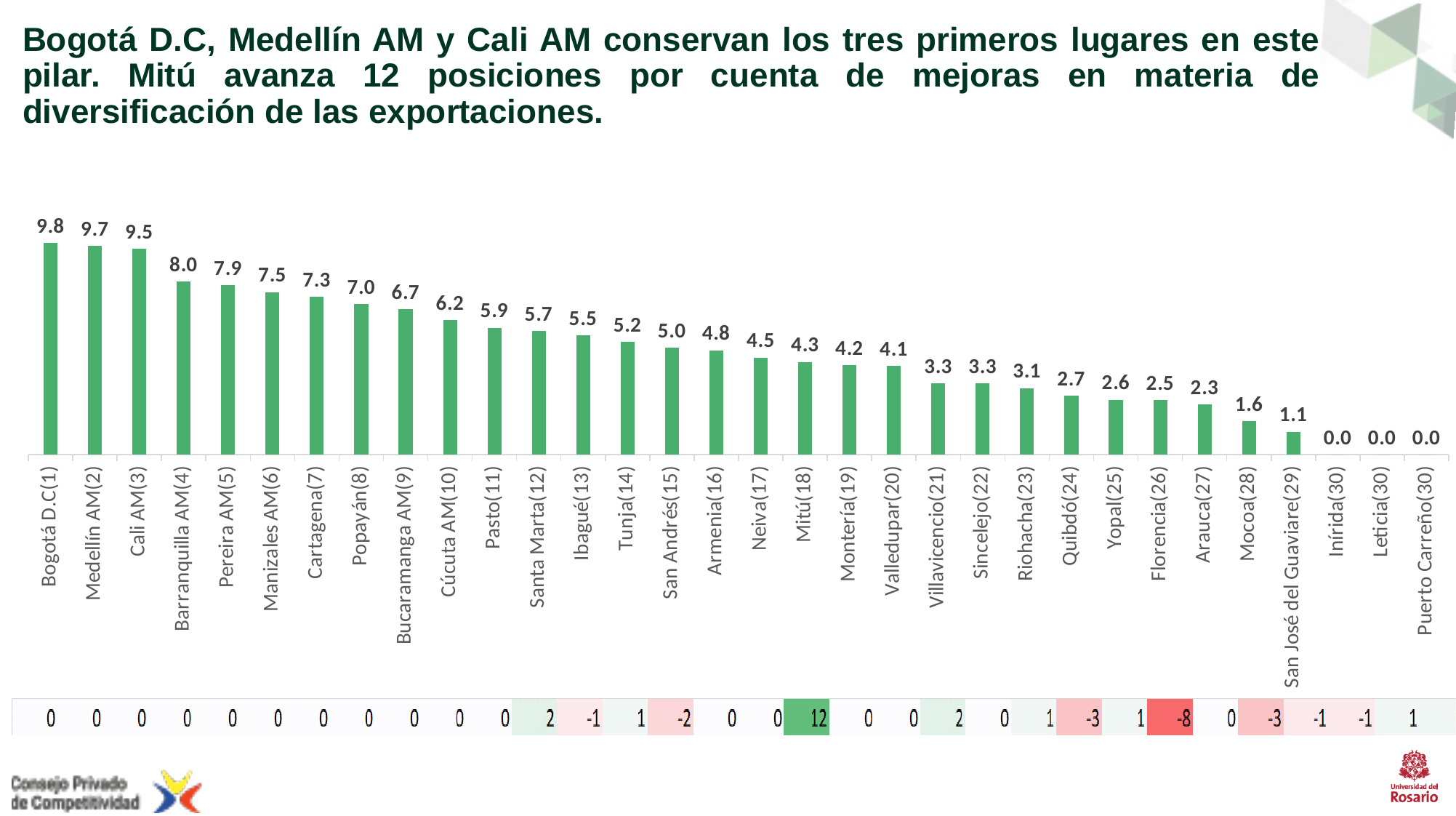
What is the difference between the values for Cartagena(7) and Pasto(11)? 1.4 What is the value shown for Mitú(18)? 4.3 What is the value shown for Barranquilla AM(4)? 8.0 What is the lowest value shown in the chart? 0.0 Which city has the highest value in the chart? Bogotá D.C(1) Do the bar values rise or fall from left to right along the x axis? Fall What kind of chart is shown on the slide? Bar chart Which has a larger value, Popayán(8) or Tunja(14)? Popayán(8) What is the value shown for San José del Guaviare(29)? 1.1 What is the difference between the values for Bogotá D.C(1) and Cali AM(3)? 0.3 How many cities are shown on the x axis of the chart? 32 What is the value shown for Bogotá D.C(1)? 9.8